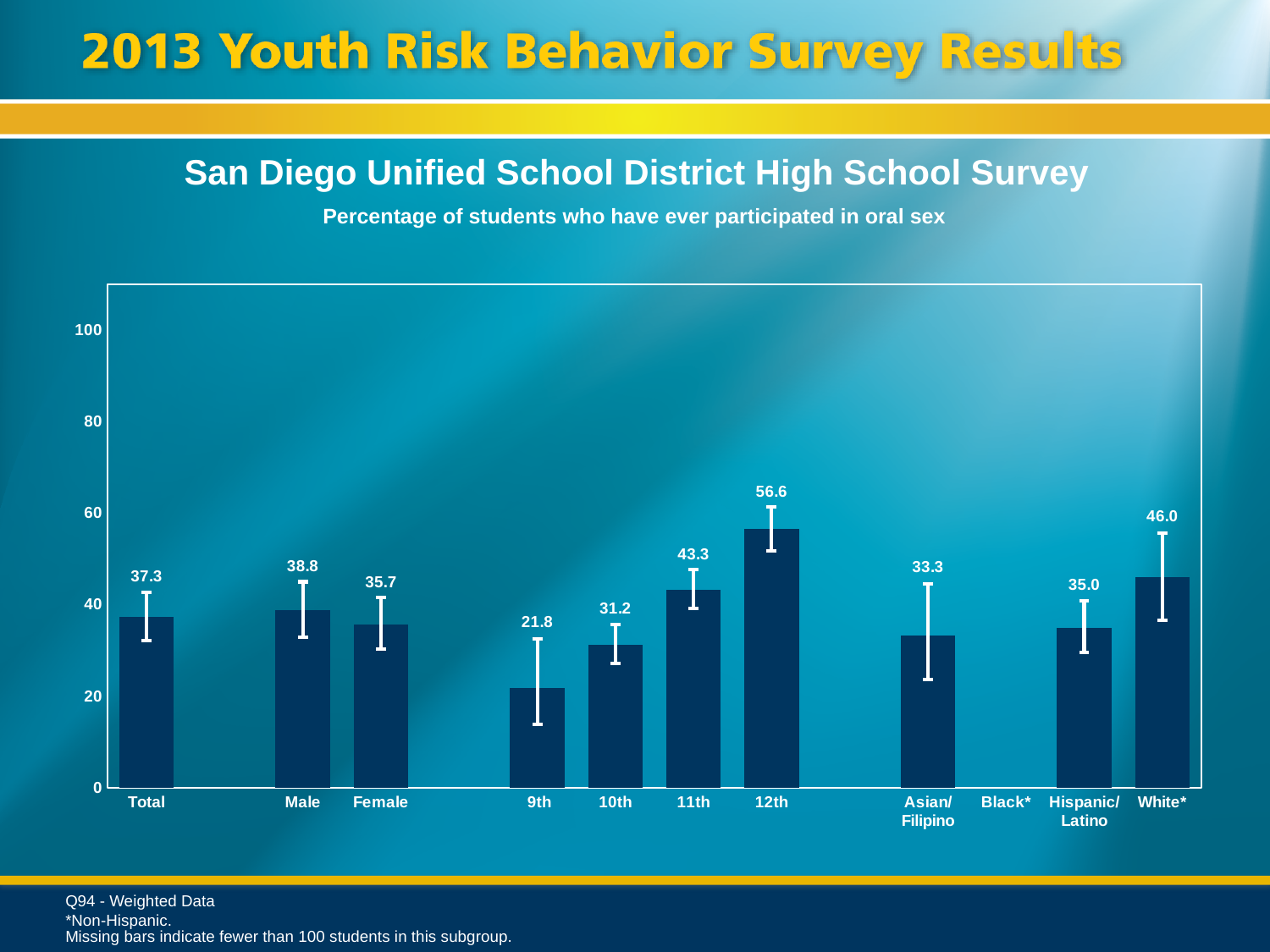
Which category has no bar plotted? Black* What is the difference between the 12th and 9th grade values? 34.8 Is the value for 11th grade greater or less than 40? greater Do the values rise or fall from 9th grade to 12th grade? rise Which category with a plotted bar has the lowest value? 9th Which category has the highest value? 12th Which is larger, the value for White* or the value for Hispanic/Latino? White* What is the value for 12th grade? 56.6 What kind of chart is shown on the slide? bar chart What is the value for Total? 37.3 What is the difference between the Male and Female values? 3.1 What is the value for Asian/Filipino? 33.3